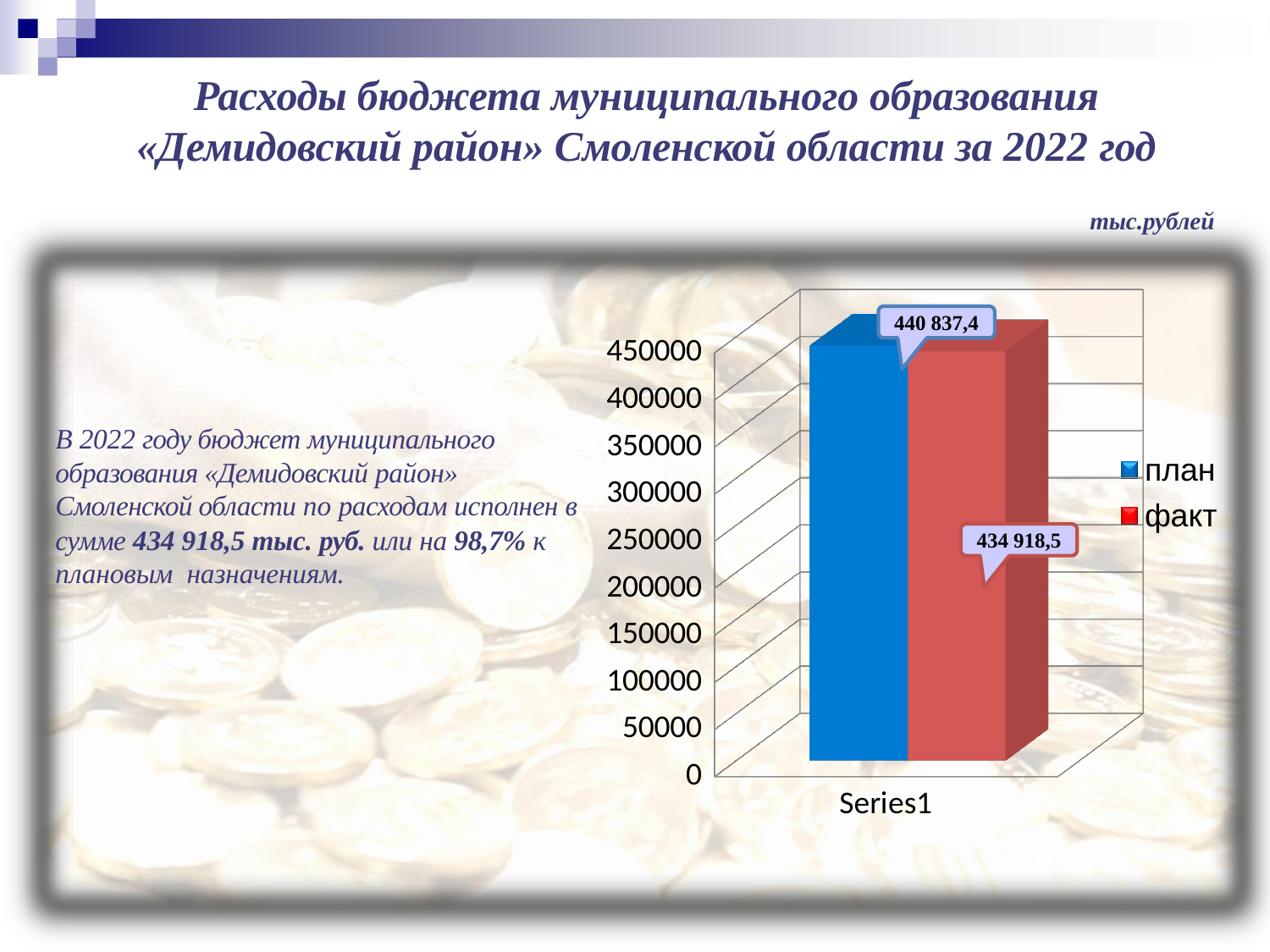
What kind of chart is shown on the slide? bar chart Which series has the lowest value on the chart? факт Is the value for факт greater or less than 400000? greater What is the value of the план (plan) bar? 440 837,4 Which series has the higher value, план or факт? план How many series does the legend list? 2 What is the value of the факт (actual) bar? 434 918,5 What colour is the факт series in the legend? red What is the label of the category on the x axis? Series1 What is the difference between the план value and the факт value? 5 918,9 How many categories are shown on the x axis of the chart? 1